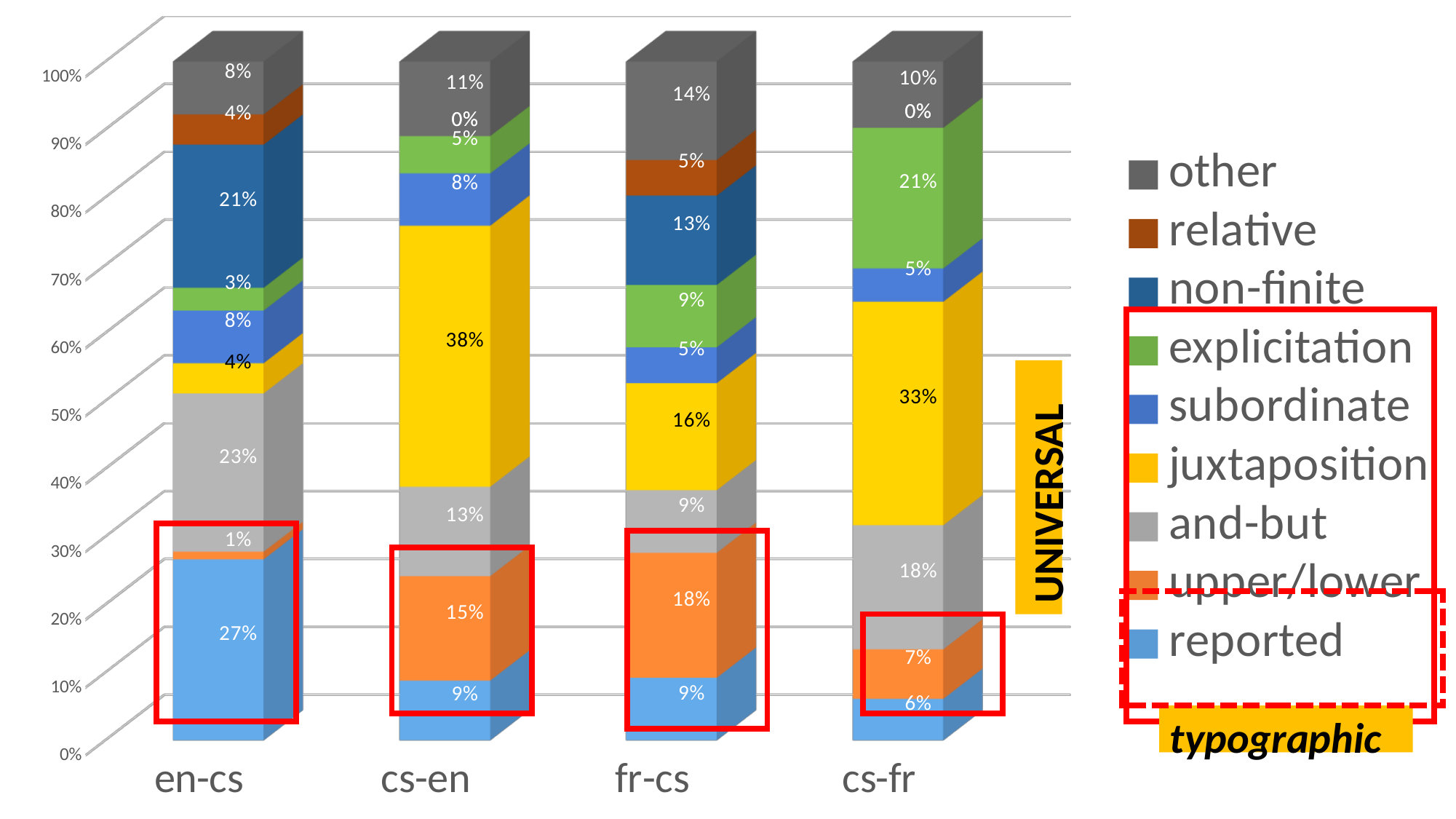
How many series does the legend list? 9 What is the value for reported in the en-cs bar? 27% What is the value for explicitation in the cs-fr bar? 21% What is the value for non-finite in the fr-cs bar? 13% Which language pair has the highest juxtaposition share? cs-en What is the value for juxtaposition in the cs-en bar? 38% How many language pairs are shown on the x axis? 4 Which language pair has the highest reported share? en-cs Which language pair has the lowest share for other? en-cs Which is larger, the and-but value for en-cs or for cs-fr? en-cs What is the value for other in the fr-cs bar? 14% What is the difference between the upper/lower values for fr-cs and cs-fr? 11 percentage points